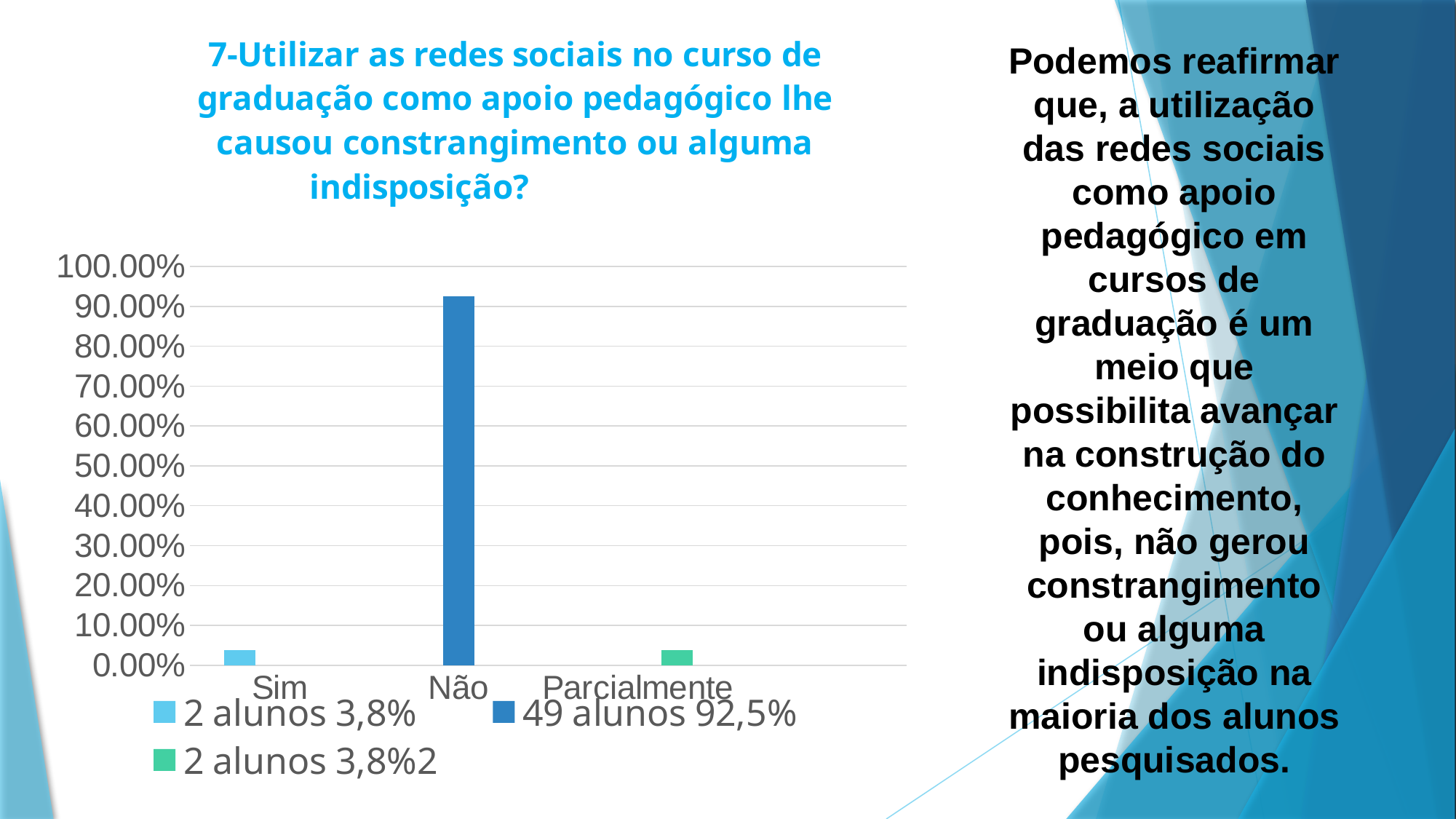
What does the legend entry for the dark blue series (Não) say? 49 alunos 92,5% What is the title of the chart? 7-Utilizar as redes sociais no curso de graduação como apoio pedagógico lhe causou constrangimento ou alguma indisposição? How many categories are shown on the x axis of the chart? 3 Is the value for Parcialmente greater or less than 10.00%? less Which category has the highest value in the chart? Não Which is larger, the value for Parcialmente or the value for Não? Não Which is larger, the value for Não or the value for Sim? Não How many series does the chart's legend list? 3 Is the value for Não greater or less than 90.00%? greater Is the value for Não greater or less than 100.00%? less What kind of chart is shown on the slide? bar chart